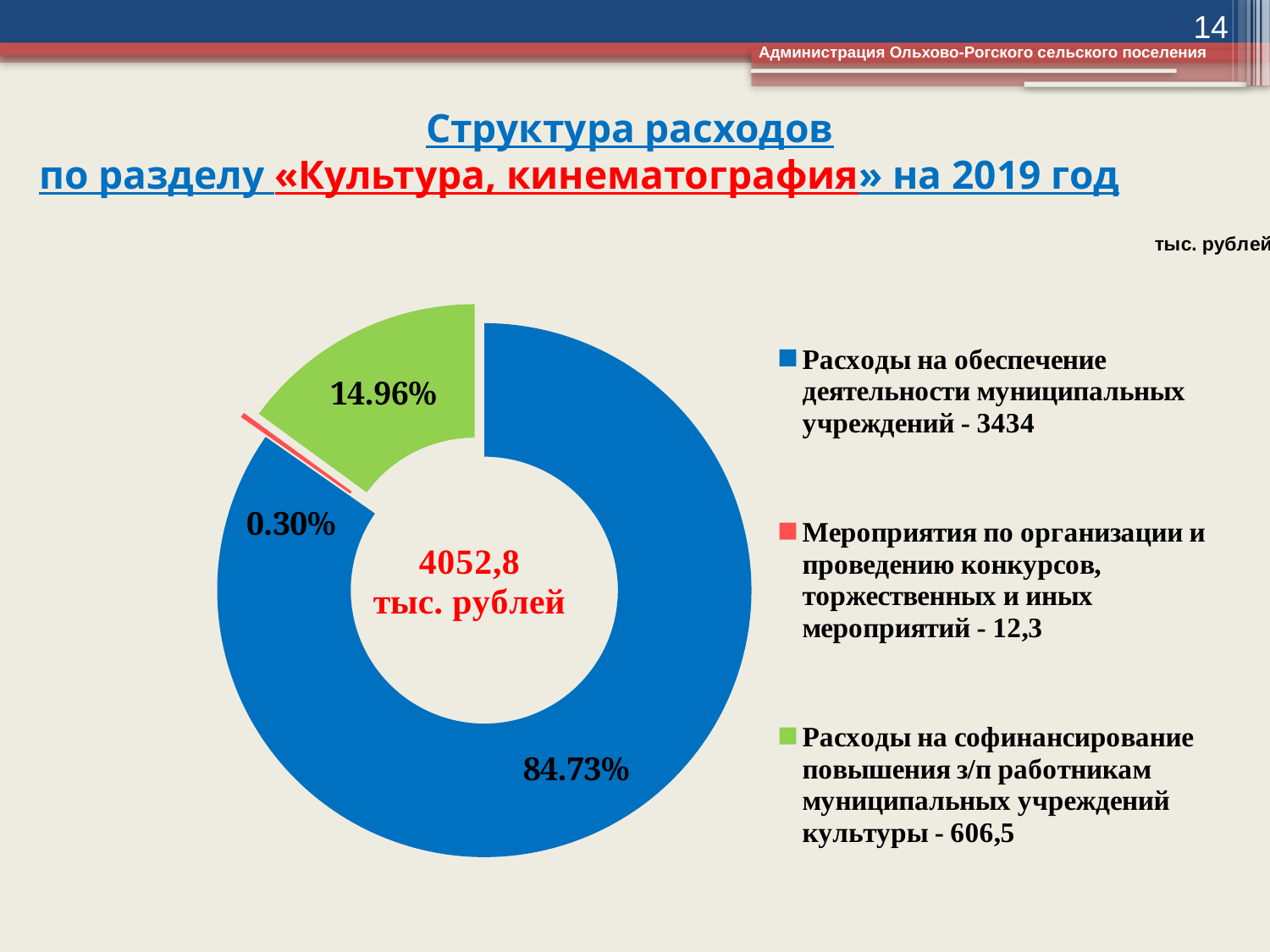
What share of the chart is labelled for "Расходы на софинансирование повышения з/п работникам муниципальных учреждений культуры"? 14.96% How many entries does the legend list? 3 What kind of chart is shown on the slide? Doughnut (pie) chart Which category has the largest share of the chart? Расходы на обеспечение деятельности муниципальных учреждений How many slices does the chart have? 3 What total amount is shown in the centre of the chart? 4052,8 тыс. рублей What share of the chart is labelled for "Расходы на обеспечение деятельности муниципальных учреждений"? 84.73% What share of the chart is labelled for "Мероприятия по организации и проведению конкурсов, торжественных и иных мероприятий"? 0.30% What value (тыс. рублей) does the legend give for "Мероприятия по организации и проведению конкурсов, торжественных и иных мероприятий"? 12,3 What value (тыс. рублей) does the legend give for "Расходы на софинансирование повышения з/п работникам муниципальных учреждений культуры"? 606,5 Which category has the smallest share of the chart? Мероприятия по организации и проведению конкурсов, торжественных и иных мероприятий What value (тыс. рублей) does the legend give for "Расходы на обеспечение деятельности муниципальных учреждений"? 3434